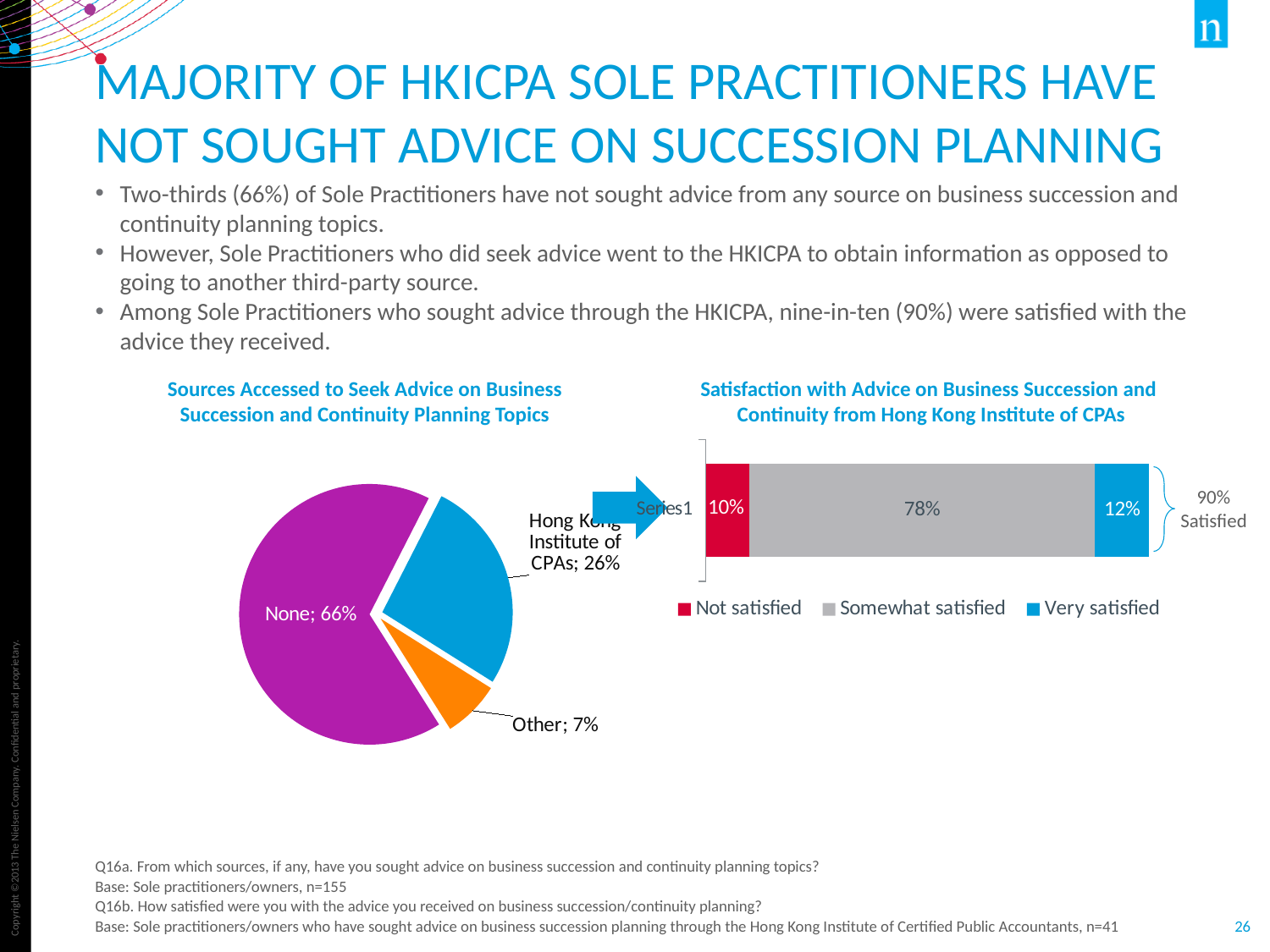
In the 'Sources Accessed to Seek Advice' pie chart, how many slices are there? 3 In the 'Satisfaction with Advice' chart, which is larger: Very satisfied or Not satisfied? Very satisfied In the 'Sources Accessed to Seek Advice' pie chart, which category has the largest slice? None In the 'Sources Accessed to Seek Advice on Business Succession and Continuity Planning Topics' chart, what share of Sole Practitioners answered None? 66% In the 'Satisfaction with Advice on Business Succession and Continuity from Hong Kong Institute of CPAs' chart, what percentage were Somewhat satisfied? 78% What type of chart is the 'Sources Accessed to Seek Advice on Business Succession and Continuity Planning Topics' chart? Pie chart In the 'Sources Accessed to Seek Advice' pie chart, what is the difference between the None share and the Hong Kong Institute of CPAs share? 40 percentage points In the 'Satisfaction with Advice' chart, what percentage were Not satisfied? 10% In the 'Sources Accessed to Seek Advice' pie chart, which category has the smallest slice? Other How many series does the legend of the 'Satisfaction with Advice' chart list? 3 In the 'Sources Accessed to Seek Advice' pie chart, what percentage sought advice from the Hong Kong Institute of CPAs? 26% In the 'Sources Accessed to Seek Advice' pie chart, what percentage is shown for Other? 7%